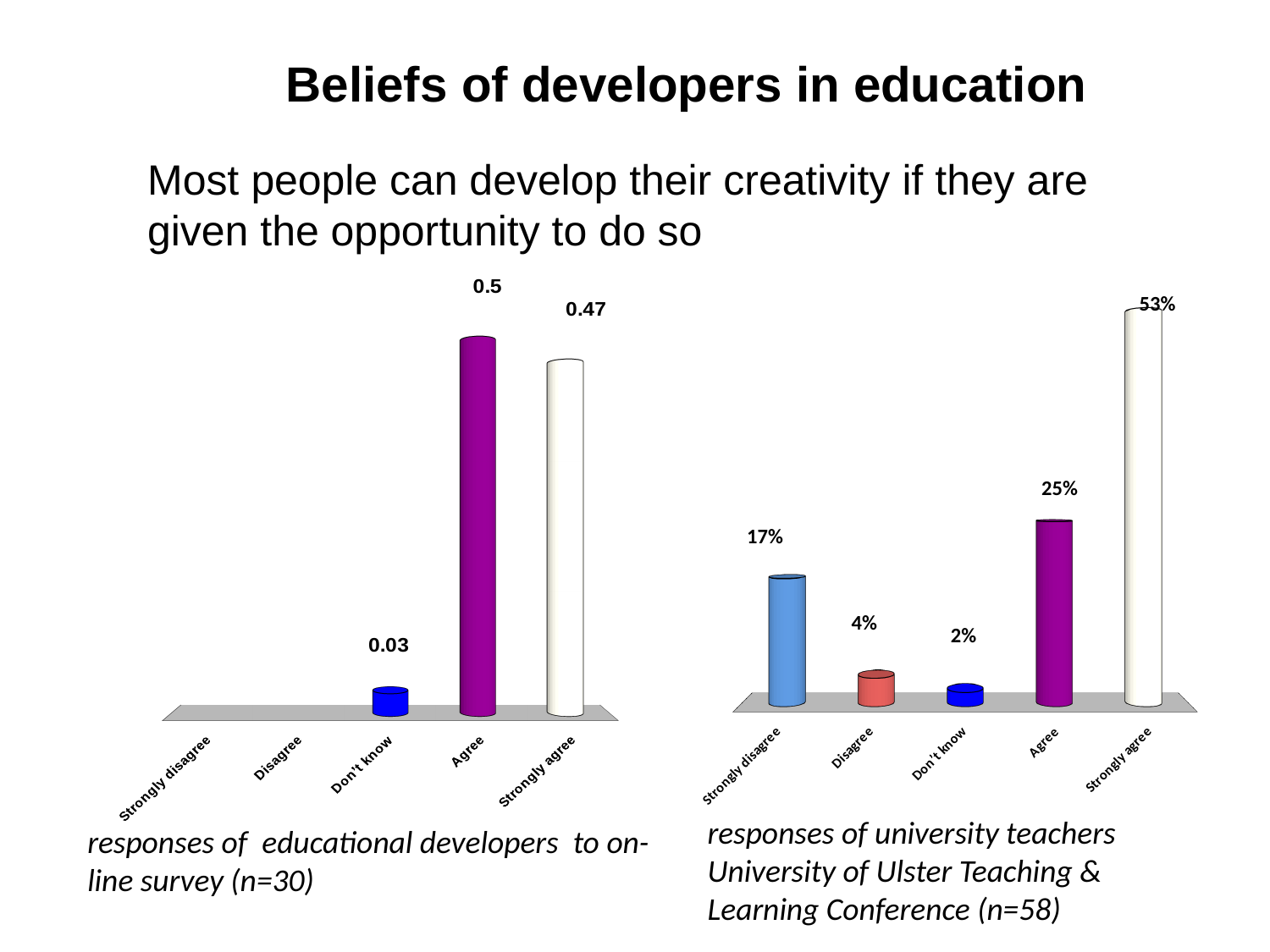
In the left chart (educational developers), which category has the highest value? Agree How many categories are shown on the x axis of the right chart (university teachers)? 5 What kind of chart is the left chart (educational developers)? Bar chart In the left chart (educational developers), what is the value for Agree? 0.5 In the right chart (university teachers), what is the difference between the values for Strongly agree and Agree? 28% In the right chart (university teachers), which is larger, the value for Agree or the value for Strongly disagree? Agree In the right chart (university teachers), what is the value for Strongly disagree? 17% In the right chart (university teachers), which category has the lowest value? Don't know What colour is the Agree bar in the right chart (university teachers)? Purple In the left chart (educational developers), what is the value for Don't know? 0.03 In the right chart (university teachers), what is the value for Strongly agree? 53% In the left chart (educational developers), what is the difference between the values for Agree and Strongly agree? 0.03